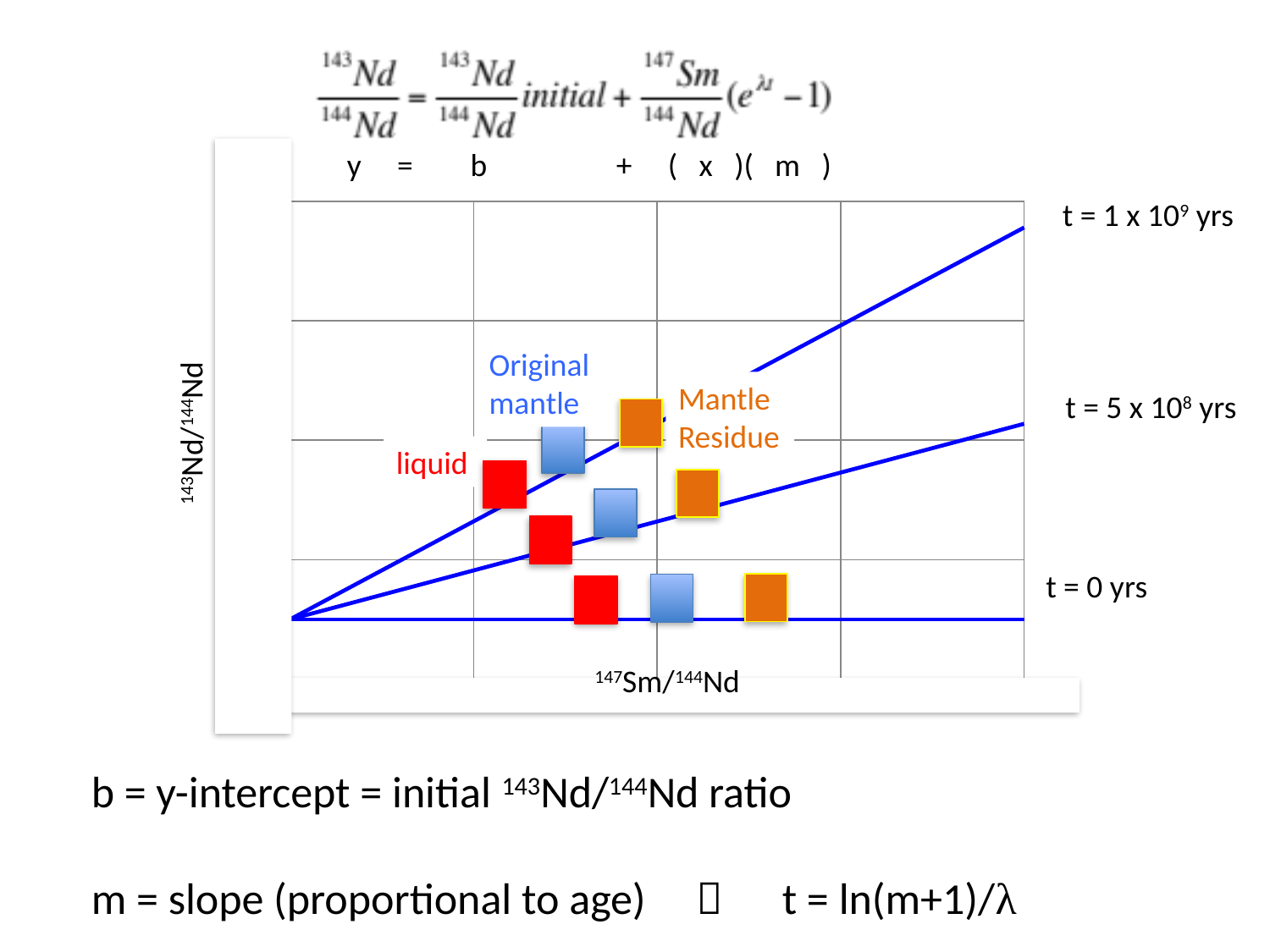
On the t = 5 x 10^8 yrs line, which has the higher 143Nd/144Nd value: the liquid or the original mantle? original mantle How many sample groups (point types) are labelled on the chart? 3 What is the label on the y axis of the chart? 143Nd/144Nd How many square data points are plotted on the chart in total? 9 On the chart, which has the higher 147Sm/144Nd value: the liquid or the mantle residue? mantle residue What age is labelled on the horizontal (flat) line of the chart? t = 0 yrs How many isochron lines are drawn on the chart? 3 What is the label on the x axis of the chart? 147Sm/144Nd Which isochron line on the chart has the steepest slope? t = 1 x 10^9 yrs What age is labelled on the middle isochron line of the chart? t = 5 x 10^8 yrs Along the t = 1 x 10^9 yrs line, does 143Nd/144Nd rise or fall as 147Sm/144Nd increases? rise Which isochron line on the chart has the smallest slope? t = 0 yrs